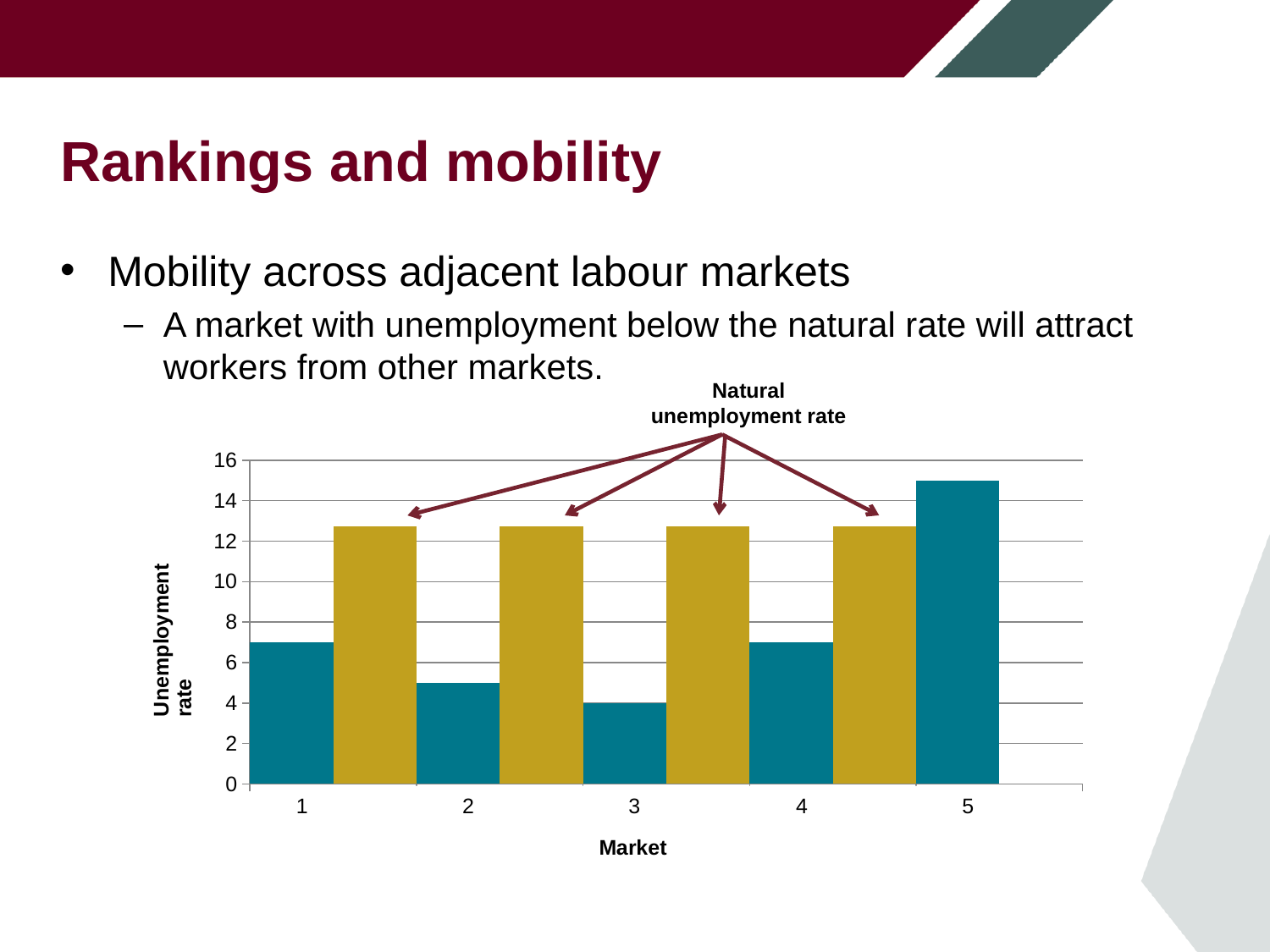
What is the title of the vertical axis of the chart? Unemployment rate Which market has the highest unemployment rate? 5 Is the natural unemployment rate shown by the gold bars greater or less than 12? greater Which market has the lowest unemployment rate? 3 Do the unemployment rates rise or fall from market 3 to market 5? rise Is the unemployment rate for market 5 greater or less than 14? greater Is the unemployment rate for market 2 greater or less than 6? less What kind of chart is shown on the slide? bar chart Which has the higher unemployment rate, market 1 or market 2? market 1 What is the unemployment rate for market 3? 4 How many markets are shown on the x axis of the chart? 5